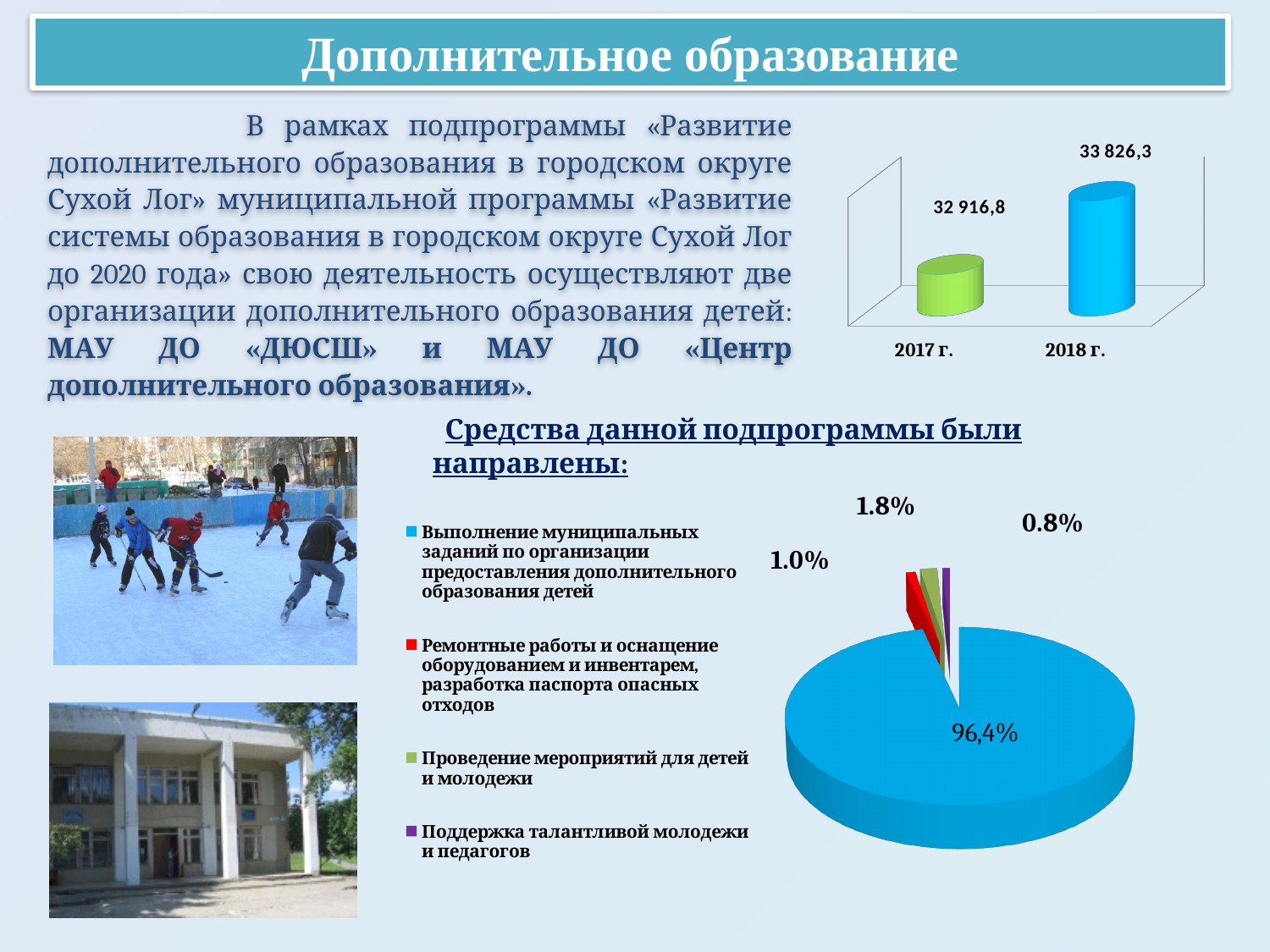
What kind of chart is shown at the bottom right of the slide? Pie chart In the pie chart at the bottom right, which category has the largest slice? Выполнение муниципальных заданий по организации предоставления дополнительного образования детей In the bar chart at the top right, do the values rise or fall from 2017 г. to 2018 г.? Rise In the pie chart at the bottom right, how many entries does the legend list? 4 In the bar chart at the top right, what is the value for 2018 г.? 33 826,3 In the bar chart at the top right, what is the value for 2017 г.? 32 916,8 In the bar chart at the top right, what is the difference between the 2018 г. and 2017 г. values? 909,5 In the bar chart at the top right, which year has the higher value? 2018 г. In the pie chart at the bottom right, what share is shown for 'Выполнение муниципальных заданий по организации предоставления дополнительного образования детей'? 96,4% In the bar chart at the top right, how many categories are shown? 2 In the bar chart at the top right, which year has the lower value? 2017 г. What kind of chart is shown at the top right of the slide? Bar chart